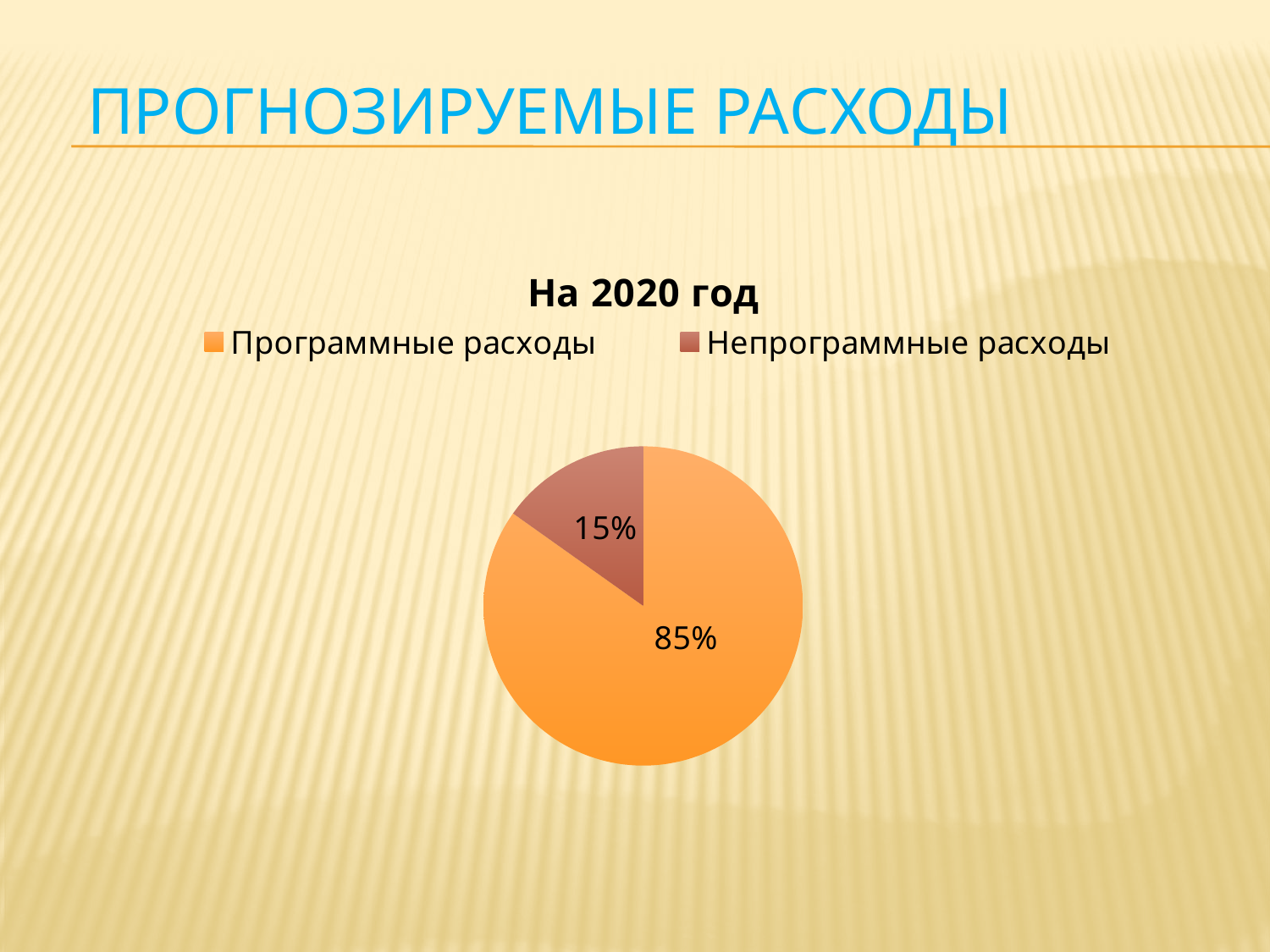
What is the difference in percentage points between Программные расходы and Непрограммные расходы? 70 Which category has the largest slice? Программные расходы What colour is the slice for Непрограммные расходы? brown Which category has the smallest slice? Непрограммные расходы What is the chart's title? На 2020 год How many entries does the legend list? 2 What share of the pie is Программные расходы? 85% Which is larger, Программные расходы or Непрограммные расходы? Программные расходы How many slices does the pie have? 2 What share of the pie is Непрограммные расходы? 15% What kind of chart is shown on the slide? pie chart